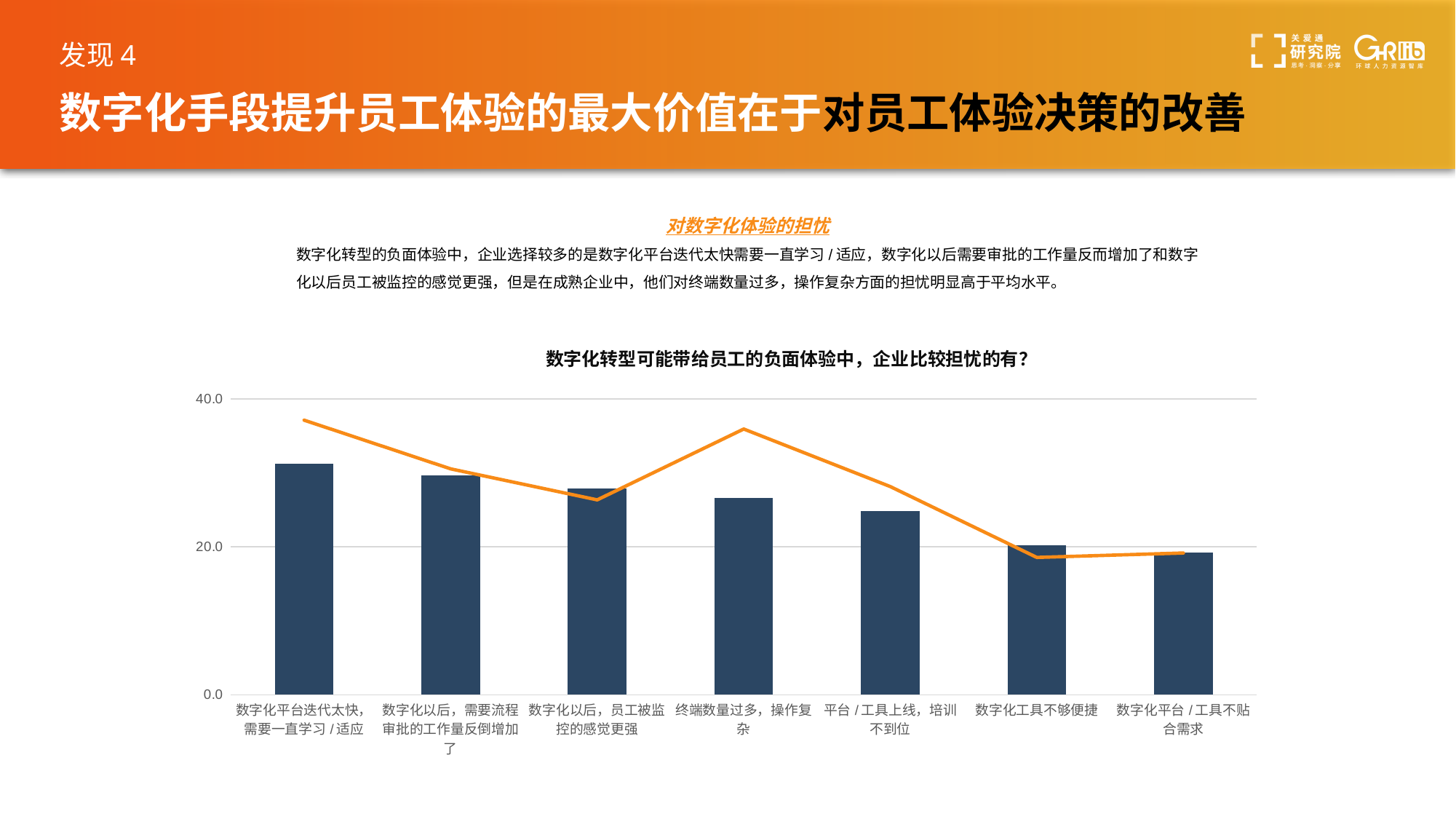
What is the title of the chart on the slide? 数字化转型可能带给员工的负面体验中，企业比较担忧的有？ How many categories are shown along the x axis of the chart? 7 Which category has the shortest bar in the chart? 数字化平台 / 工具不贴合需求 Do the bar values rise or fall from left to right across the x axis? Fall Is the orange line value for 数字化工具不够便捷 greater or less than 20.0? less Is the bar value for 数字化平台迭代太快，需要一直学习 / 适应 greater or less than 20.0? greater For 终端数量过多，操作复杂, which is higher: the bar or the orange line point? The orange line point Which bar is taller: 数字化平台迭代太快，需要一直学习 / 适应 or 平台 / 工具上线，培训不到位? 数字化平台迭代太快，需要一直学习 / 适应 Is the orange line value for 终端数量过多，操作复杂 greater or less than 20.0? greater Which category has the tallest bar in the chart? 数字化平台迭代太快，需要一直学习 / 适应 What kind of chart is shown on the slide? A bar chart with an overlaid line